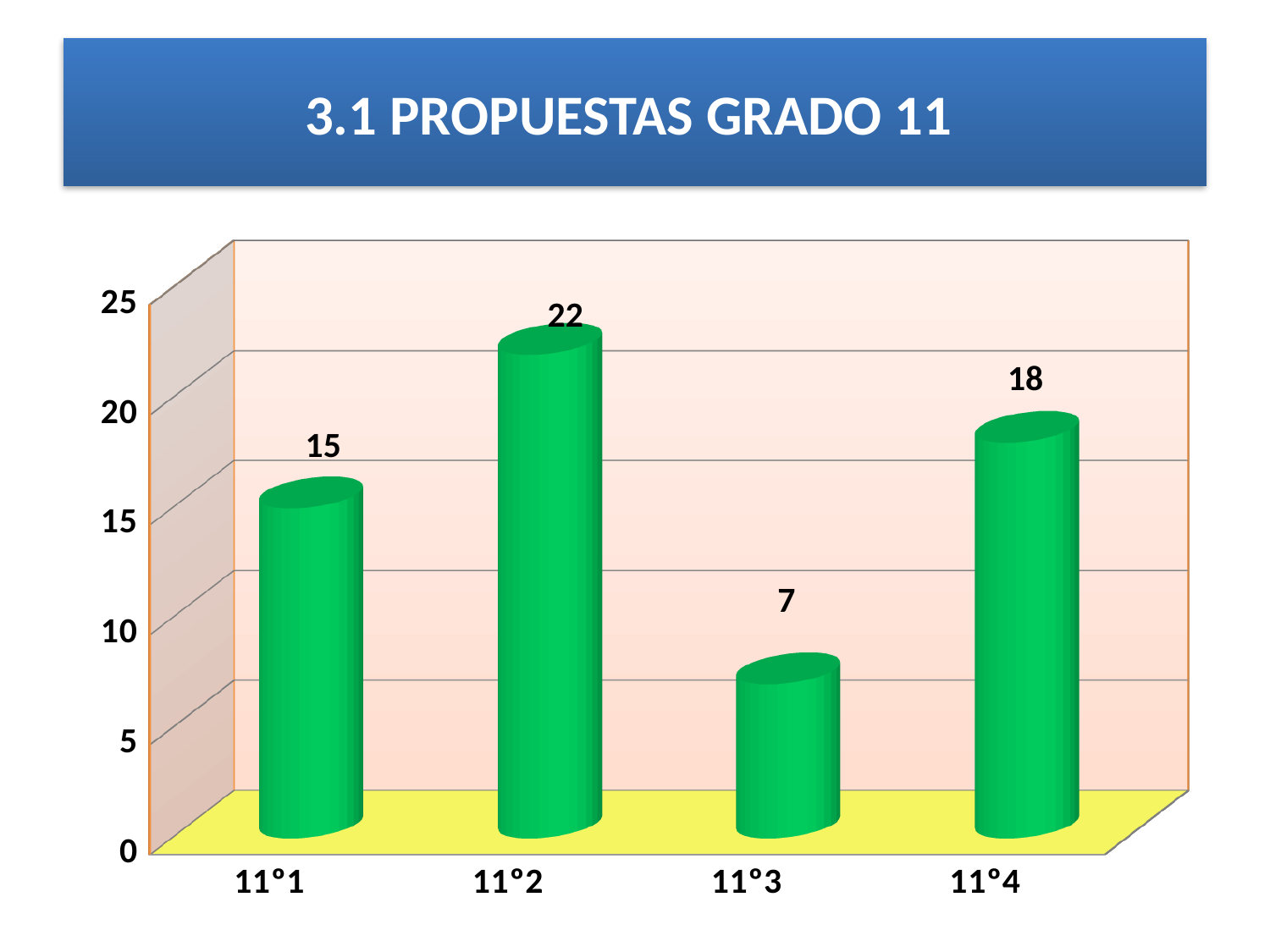
What is the difference between the values for 11°4 and 11°1? 3 What is the value for 11°2? 22 What is the value for 11°4? 18 Which is larger, the value for 11°1 or the value for 11°4? 11°4 What is the value for 11°1? 15 What is the title of the slide? 3.1 PROPUESTAS GRADO 11 What is the difference between the values for 11°2 and 11°3? 15 What is the value for 11°3? 7 How many categories are shown on the x axis? 4 Which category has the lowest value? 11°3 What kind of chart is shown on the slide? bar chart Which category has the highest value? 11°2